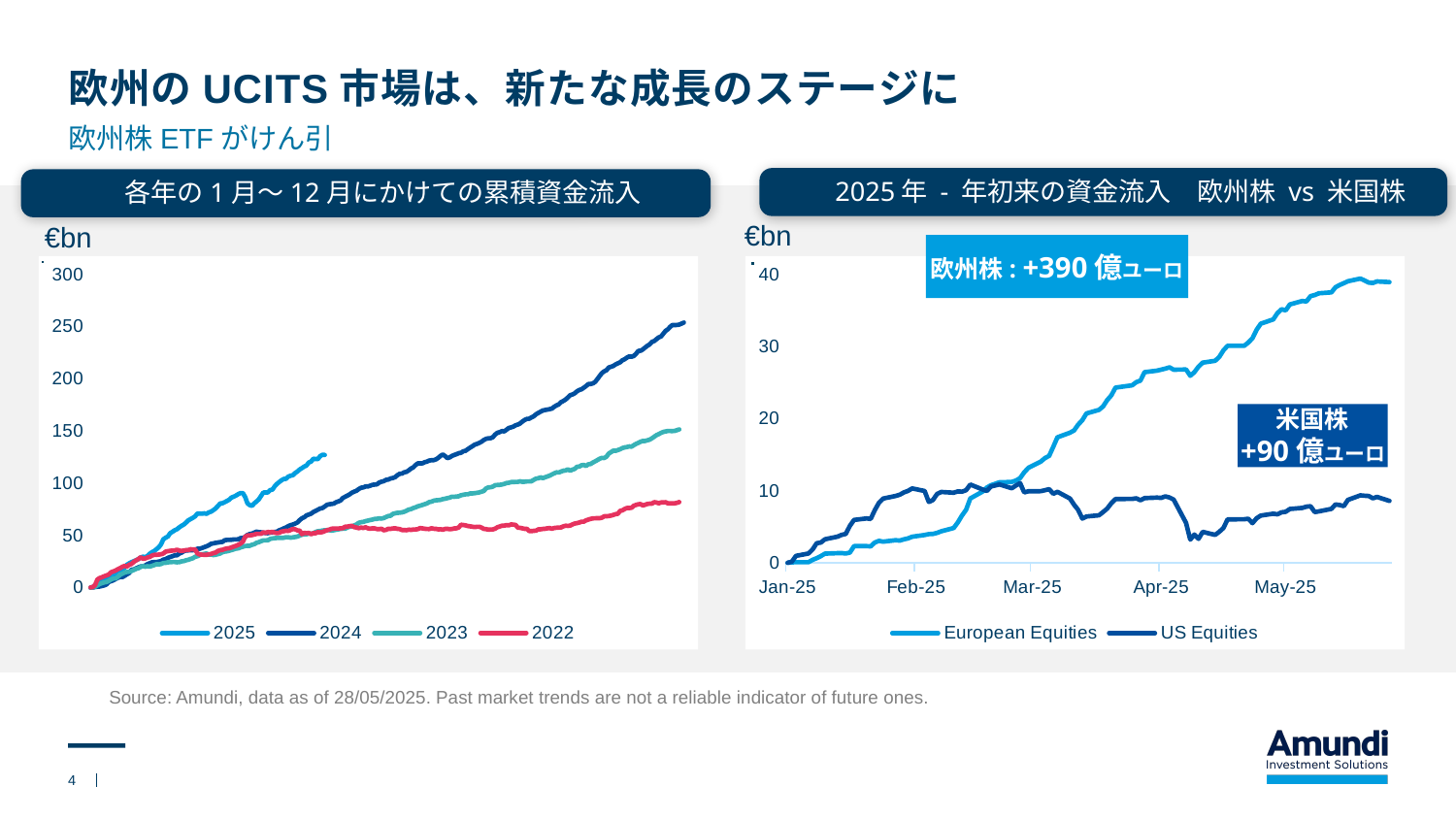
In the right chart (2025年 - 年初来の資金流入 欧州株 vs 米国株), what year-to-date inflow is annotated for 米国株? +90億ユーロ How many series does the legend of the left chart (各年の1月〜12月にかけての累積資金流入) list? 4 In the right chart (2025年 - 年初来の資金流入 欧州株 vs 米国株), is the final value for US Equities greater or less than 20? less How many series does the legend of the right chart (2025年 - 年初来の資金流入 欧州株 vs 米国株) list? 2 In the right chart (2025年 - 年初来の資金流入 欧州株 vs 米国株), is the final value for European Equities greater or less than 30? greater What is the first x-axis label on the right chart (2025年 - 年初来の資金流入 欧州株 vs 米国株)? Jan-25 In the right chart (2025年 - 年初来の資金流入 欧州株 vs 米国株), what year-to-date inflow is annotated for 欧州株? +390億ユーロ In the right chart (2025年 - 年初来の資金流入 欧州株 vs 米国株), which series is higher at the end of the period, European Equities or US Equities? European Equities What kind of chart is the left chart titled 各年の1月〜12月にかけての累積資金流入? Line chart In the left chart (各年の1月〜12月にかけての累積資金流入), which year's line reaches the highest value? 2024 In the left chart (各年の1月〜12月にかけての累積資金流入), does the 2024 line generally rise or fall along the x axis? Rise In the left chart (各年の1月〜12月にかけての累積資金流入), is the final value of the 2022 line greater or less than 100? less